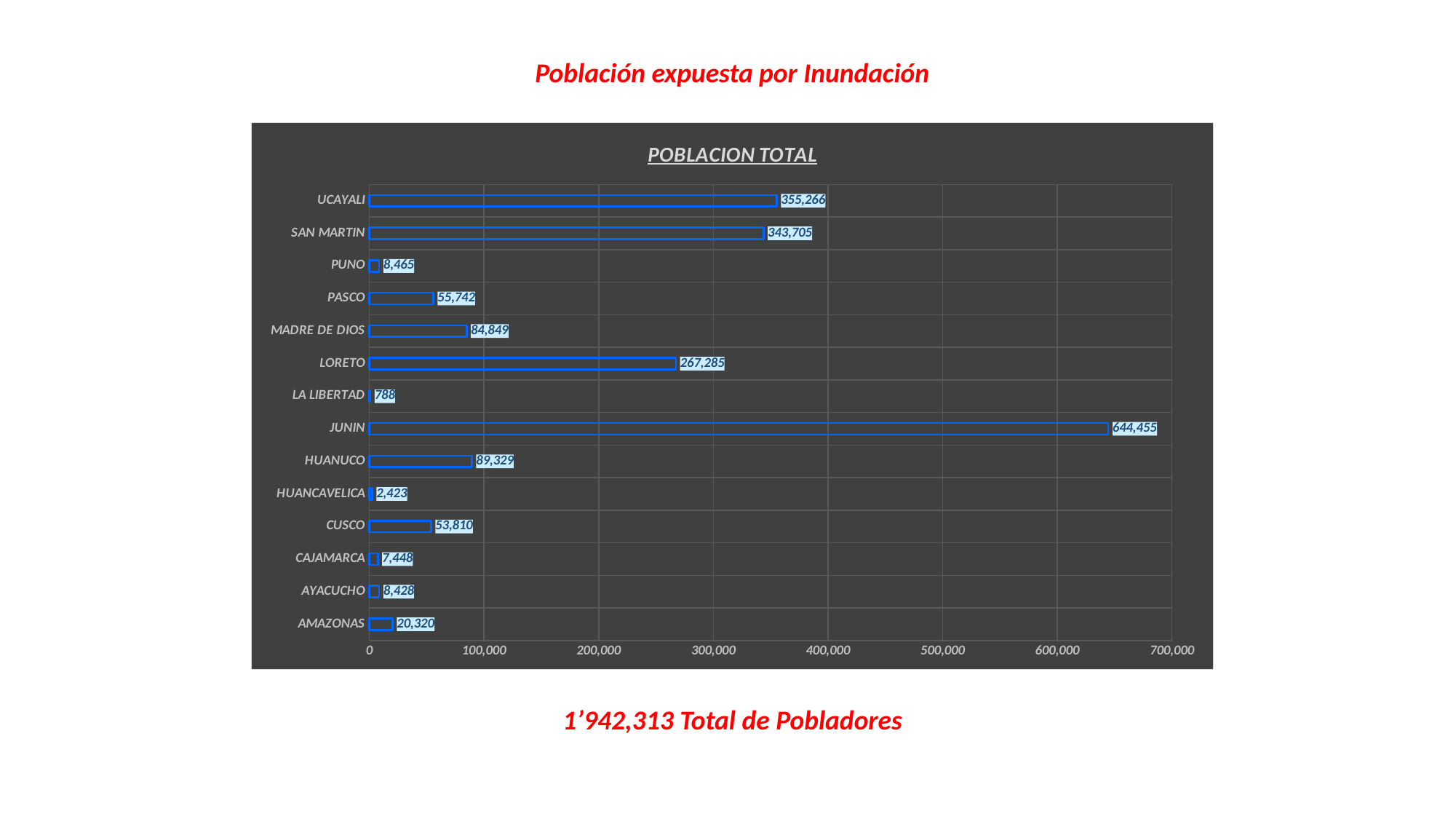
Is the value for LORETO greater or less than 200,000? greater What is the value for LORETO? 267,285 What is the value for AMAZONAS? 20,320 How many categories are shown in the chart? 14 Which category has the lowest value? LA LIBERTAD What kind of chart is shown on the slide? bar chart Which is larger, the value for LORETO or the value for SAN MARTIN? SAN MARTIN What is the title of the chart? POBLACION TOTAL Which category has the highest value? JUNIN What is the difference between the values for UCAYALI and SAN MARTIN? 11,561 What is the difference between the values for JUNIN and UCAYALI? 289,189 What is the value for JUNIN? 644,455